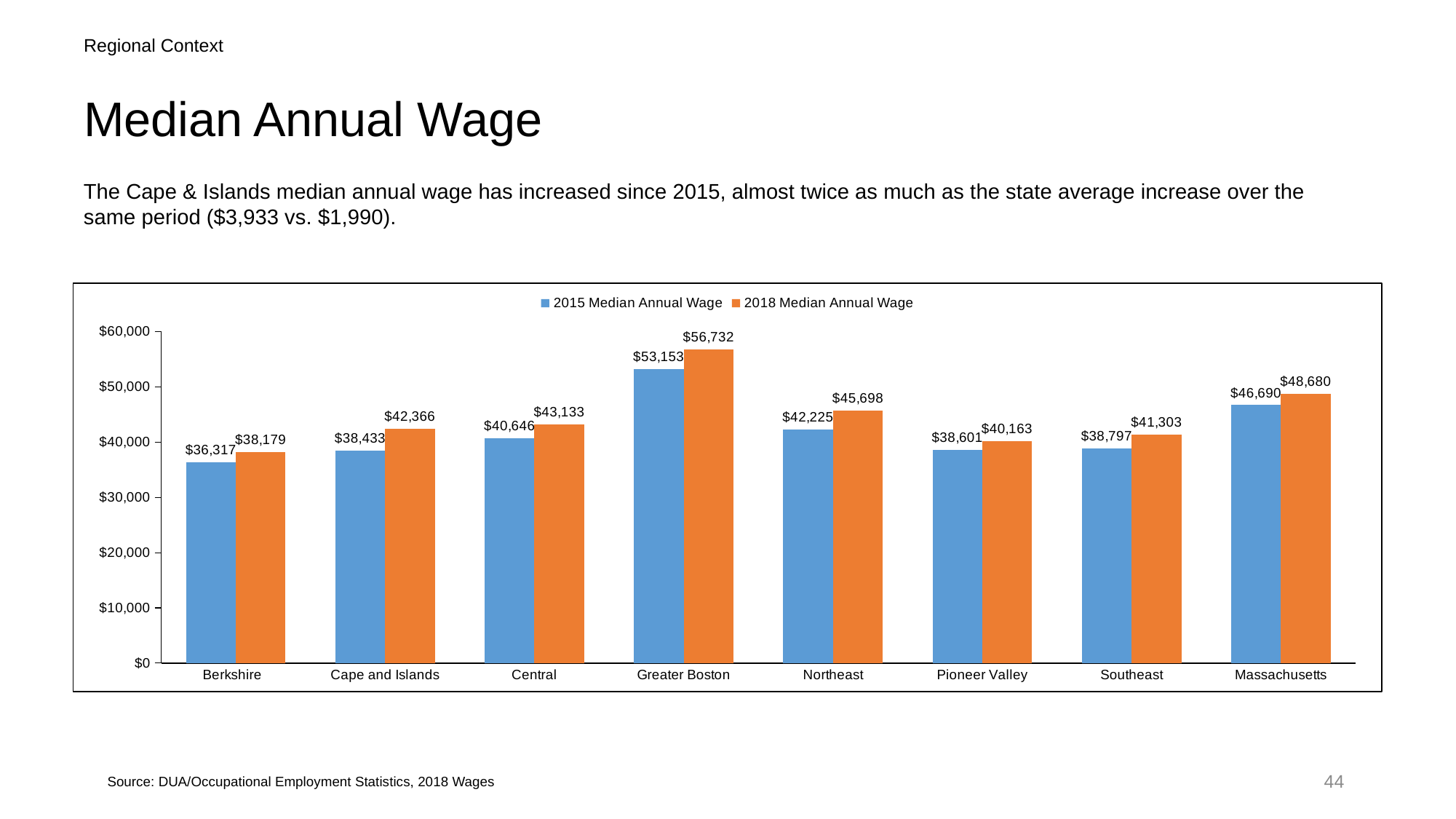
Which region had the highest 2018 Median Annual Wage? Greater Boston How many series does the chart legend list? 2 Is the 2015 Median Annual Wage for Central greater or less than $40,000? greater What is the difference between the 2018 and 2015 Median Annual Wage for Northeast? $3,473 What kind of chart is shown on the slide? Bar chart Which colour represents the 2018 Median Annual Wage series? Orange What was the 2015 Median Annual Wage for Greater Boston? $53,153 What was the 2018 Median Annual Wage for Cape and Islands? $42,366 How many regions are shown on the x axis of the chart? 8 Which is larger: the 2018 Median Annual Wage for Pioneer Valley or for Southeast? Southeast Which region had the lowest 2015 Median Annual Wage? Berkshire What was the 2015 Median Annual Wage for Massachusetts? $46,690